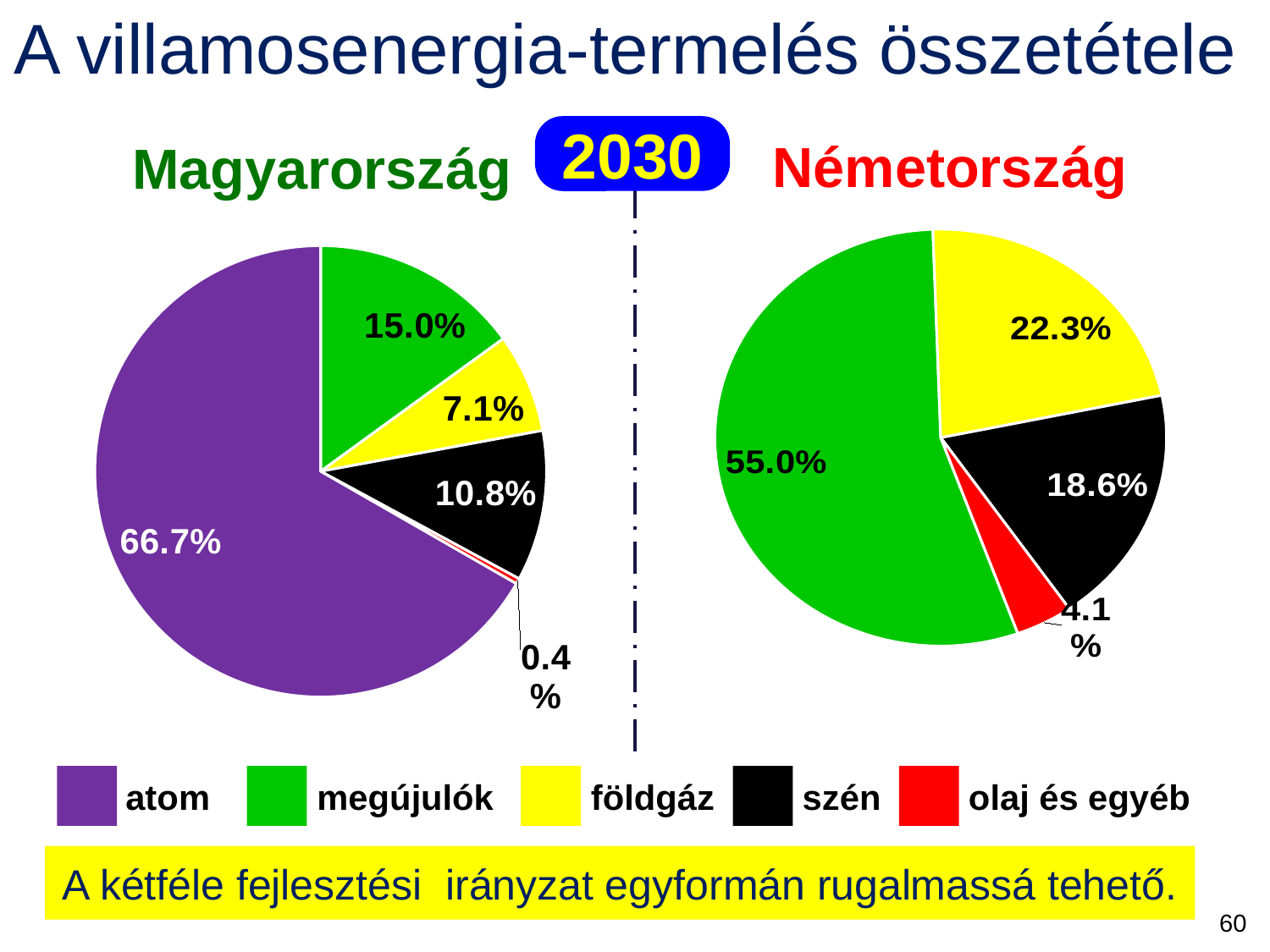
In the Németország pie chart, what share does földgáz have? 22.3% In the Magyarország pie chart, which category has the largest share? atom In the Németország pie chart, which category has the smallest share? olaj és egyéb In the Magyarország pie chart, what share does atom have? 66.7% Which year is shown between the two pie charts? 2030 How many categories does the legend list? 5 In the Németország pie chart, what share does megújulók have? 55.0% In the Magyarország pie chart, what share does szén have? 10.8% In the Németország pie chart, what is the difference between the shares of földgáz and szén? 3.7% What kind of chart is used for Magyarország on the slide? pie chart In the Magyarország pie chart, which is larger: the share of megújulók or the share of szén? megújulók In the Magyarország pie chart, which category has the smallest share? olaj és egyéb